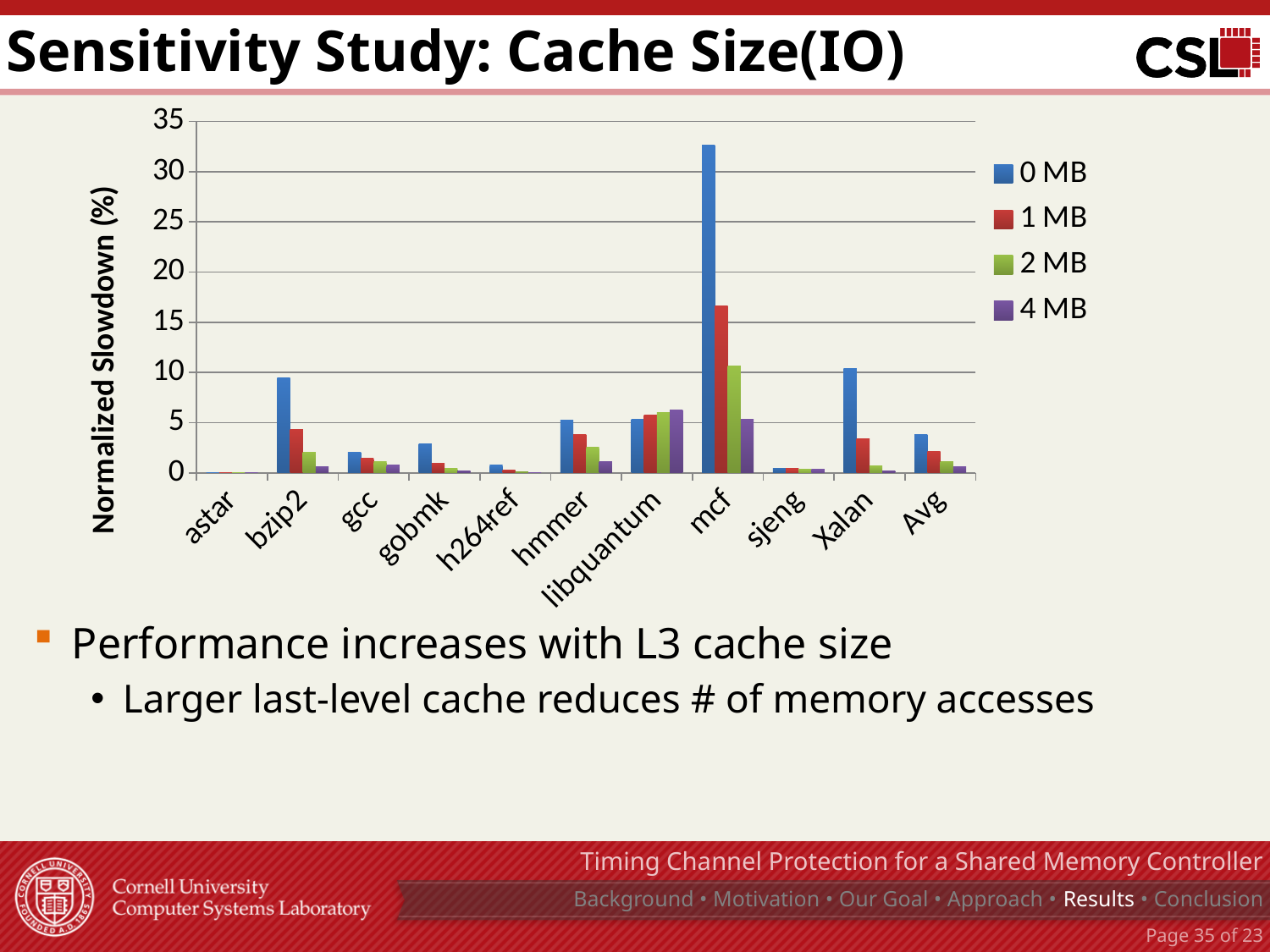
Which is larger for the 0 MB series: mcf or Xalan? mcf How many series does the legend list? 4 Is the 0 MB value for mcf greater or less than 30? greater How many benchmark categories are shown on the x axis? 11 Which category has the lowest 0 MB bar? astar What is the label of the y axis? Normalized Slowdown (%) Is the 0 MB value for Avg greater or less than 5? less What kind of chart is shown on the slide? bar chart Which category has the highest 0 MB bar? mcf Is the 0 MB value for bzip2 greater or less than 10? less For mcf, do the values rise or fall as the cache size increases from 0 MB to 4 MB? fall